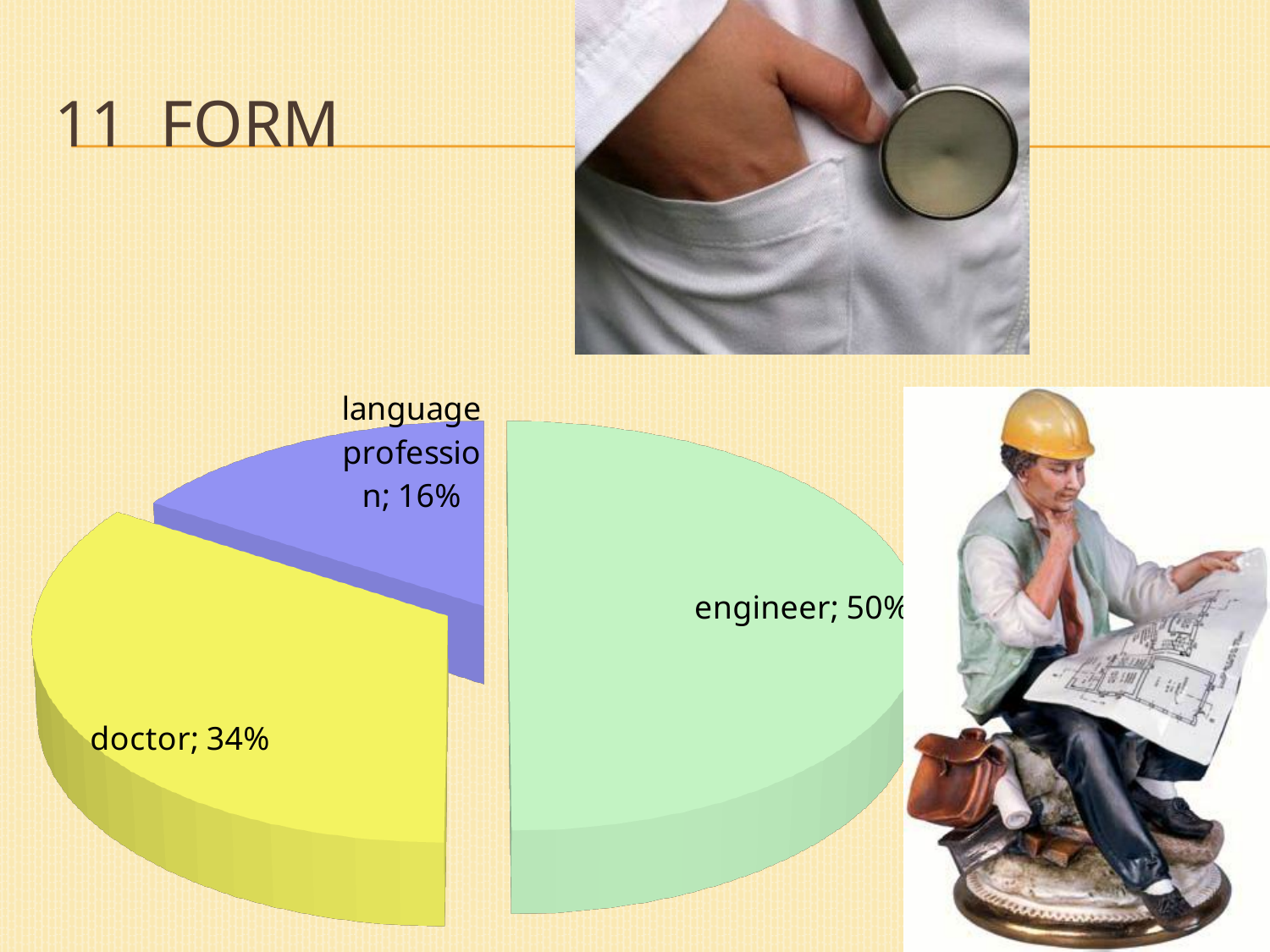
What share of the pie does language profession have? 16% What share of the pie does engineer have? 50% What colour is the engineer slice? green Which is larger, the share for doctor or the share for language profession? doctor Which category has the smallest slice of the pie? language profession What is the difference in percentage points between doctor and language profession? 18 Which category has the largest slice of the pie? engineer What kind of chart is shown on the slide? pie chart What colour is the doctor slice? yellow How many slices does the pie chart have? 3 What share of the pie does doctor have? 34% What is the difference in percentage points between engineer and doctor? 16